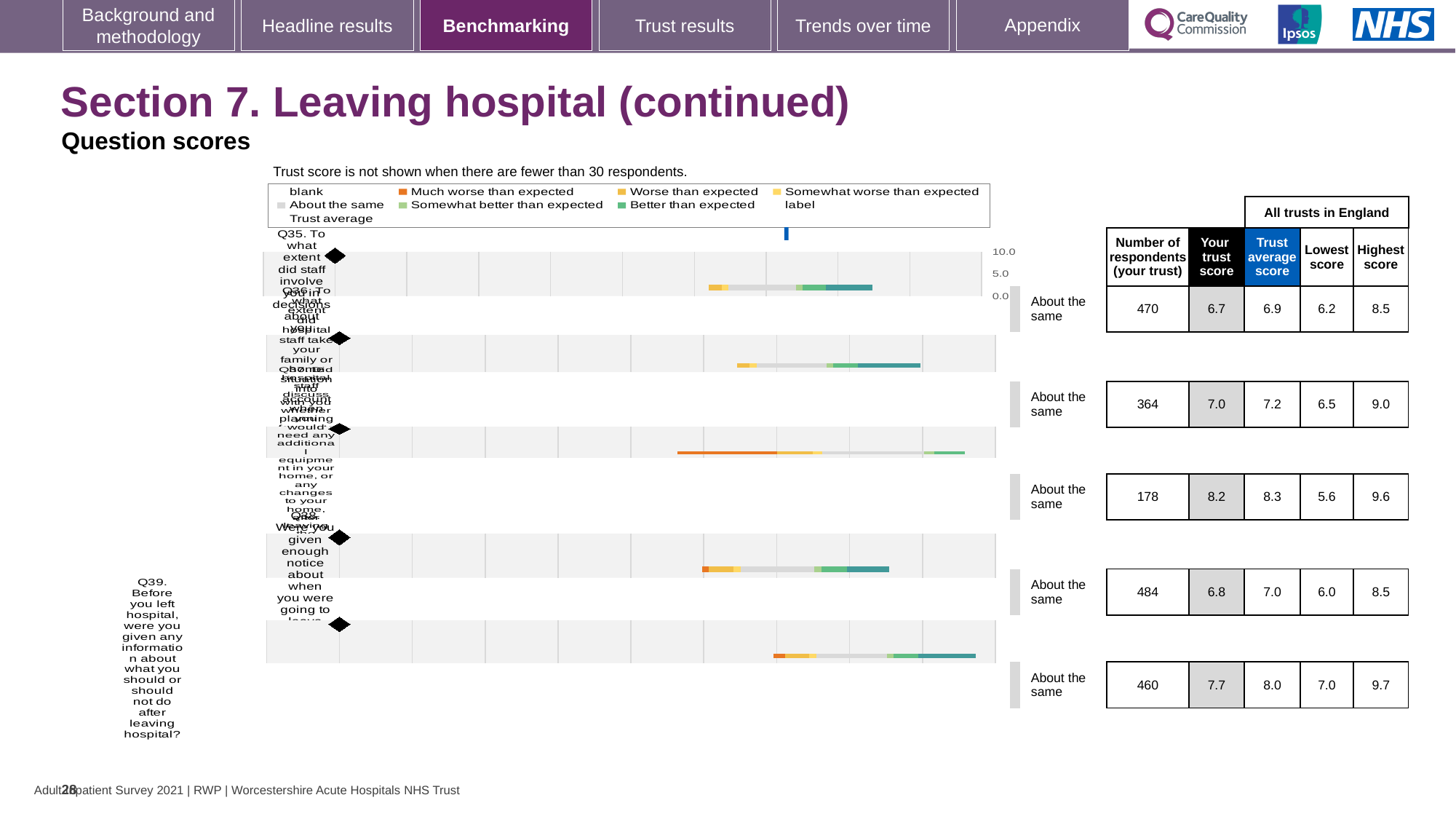
What is the smallest value in the 'Lowest score' column of the table next to the chart? 5.6 What is the highest score across all trusts in England for Q39? 9.7 How many respondents are shown for Q39 (the last question in the chart)? 460 What benchmark category label is shown for Q35 in the chart? About the same What is the largest 'Your trust score' value shown in the table next to the chart? 8.2 Is the trust score for Q35 greater or less than 5.0 on the chart axis? greater For Q39, which is larger: your trust score or the trust average score? Trust average score What is the 'Your trust score' value for Q35 (the first question in the chart)? 6.7 What is the lowest score across all trusts in England for Q39? 7.0 How many questions (bars) are plotted in the question scores chart? 5 What type of chart is used to show the question scores on this slide? bar chart For Q35, what is the difference between the trust average score and your trust score? 0.2